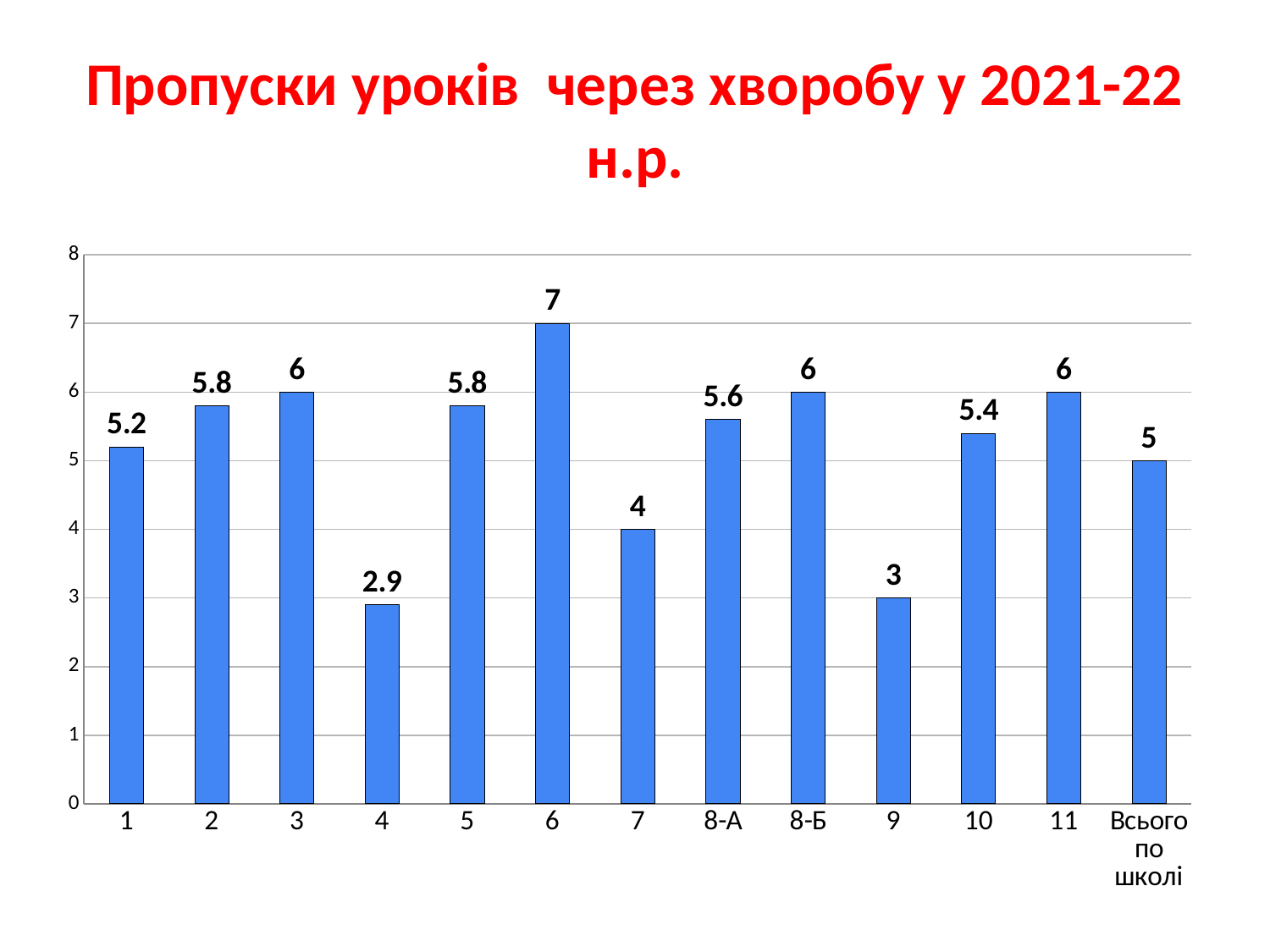
How many categories are shown on the x axis? 13 Which is larger, the value for category 10 or the value for category 7? 10 Which category has the highest value? 6 Which category has the lowest value? 4 What is the value for category 4? 2.9 Is the value for category 1 greater or less than 5? greater What is the title of the slide? Пропуски уроків через хворобу у 2021-22 н.р. What is the difference between the values for category 6 and category 9? 4 What is the value for 'Всього по школі'? 5 What is the difference between the values for category 2 and category 10? 0.4 What is the value for category 8-А? 5.6 What kind of chart is shown on the slide? bar chart